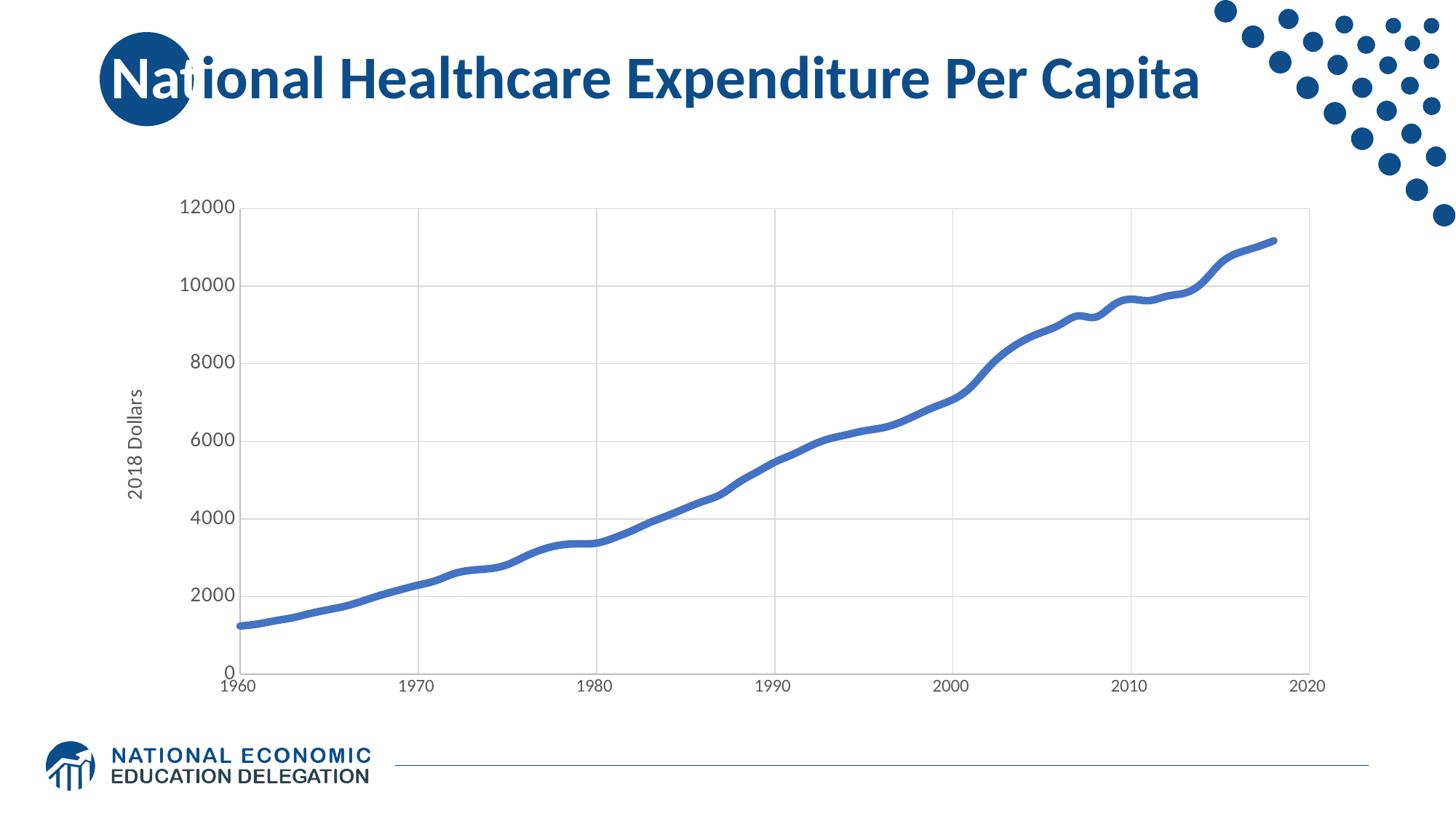
Is the value for 2010 greater or less than 10000? less What is the title of the chart? National Healthcare Expenditure Per Capita Which of the two values is larger, the value for 1970 or the value for 2000? 2000 Is the value for 1980 greater or less than 4000? less Do the values rise or fall from 1960 to 2018 along the x axis? rise Is the value for 1990 greater or less than 4000? greater What kind of chart is shown on the slide? line chart What is the label on the vertical axis of the chart? 2018 Dollars In which year shown on the x axis is the value lowest? 1960